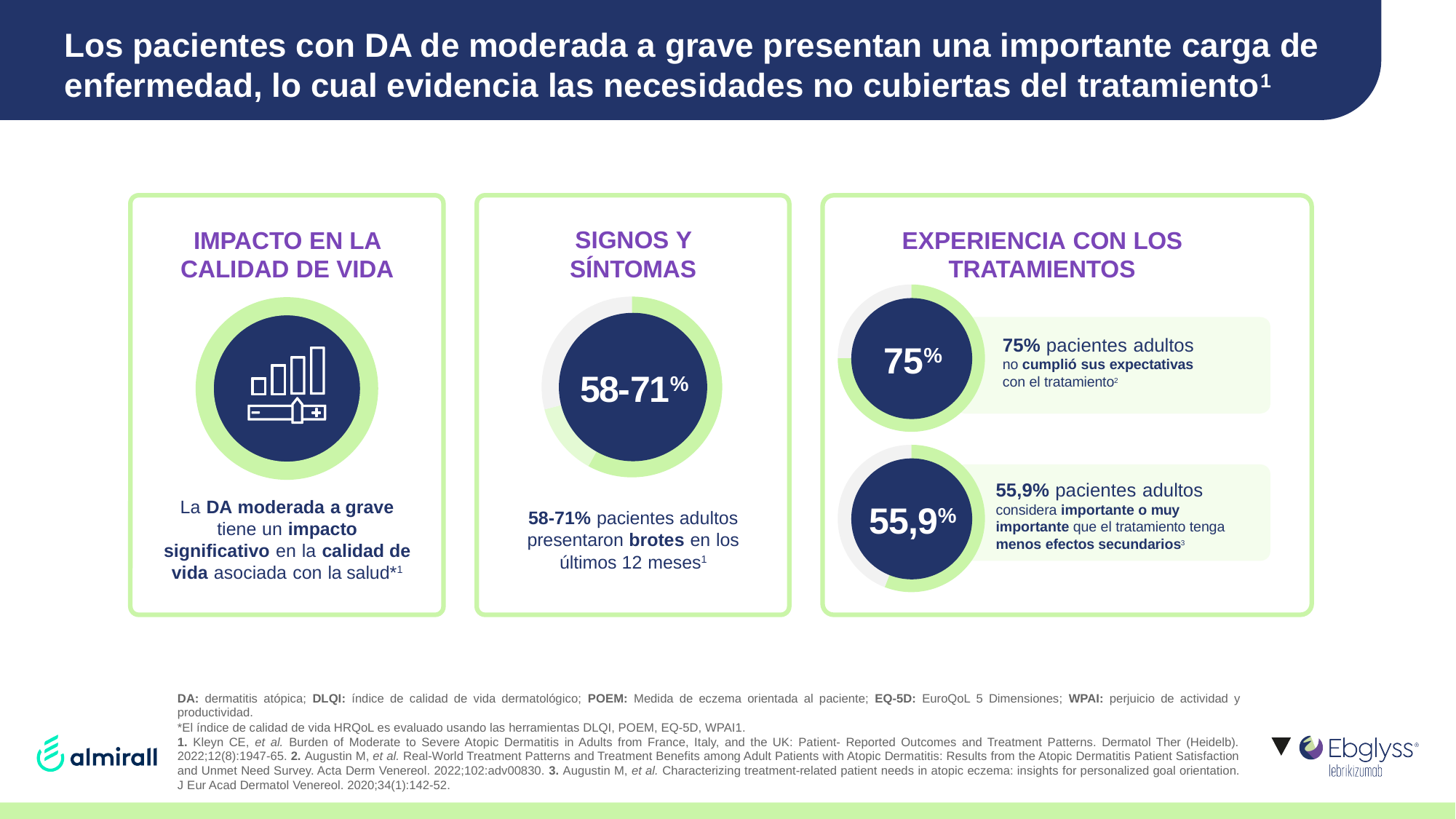
In the EXPERIENCIA CON LOS TRATAMIENTOS panel, what percentage of adult patients did not meet their expectations with treatment? 75% What kind of chart is used to display the percentages on this slide? Doughnut (ring) chart Across all the ring charts on the slide, which one shows the highest value? 75% (unmet expectations with treatment) In the EXPERIENCIA CON LOS TRATAMIENTOS panel, what is the difference between the two ring chart values, 75% and 55,9%? 19,1% How many ring charts are shown in the EXPERIENCIA CON LOS TRATAMIENTOS panel? 2 What is the title of the panel containing the 75% and 55,9% ring charts? EXPERIENCIA CON LOS TRATAMIENTOS What colour is the filled portion of the rings in the ring charts? Green In the EXPERIENCIA CON LOS TRATAMIENTOS panel, what percentage of adult patients consider it important or very important that treatment has fewer side effects? 55,9% In the SIGNOS Y SÍNTOMAS panel, what value is printed in the centre of the ring chart? 58-71% Across all the ring charts on the slide, which one shows the lowest value? 55,9% (fewer side effects important) How many ring charts with a printed percentage are shown on the slide in total? 3 In the EXPERIENCIA CON LOS TRATAMIENTOS panel, which ring chart shows the larger value: the one about unmet expectations or the one about fewer side effects? Unmet expectations (75%)